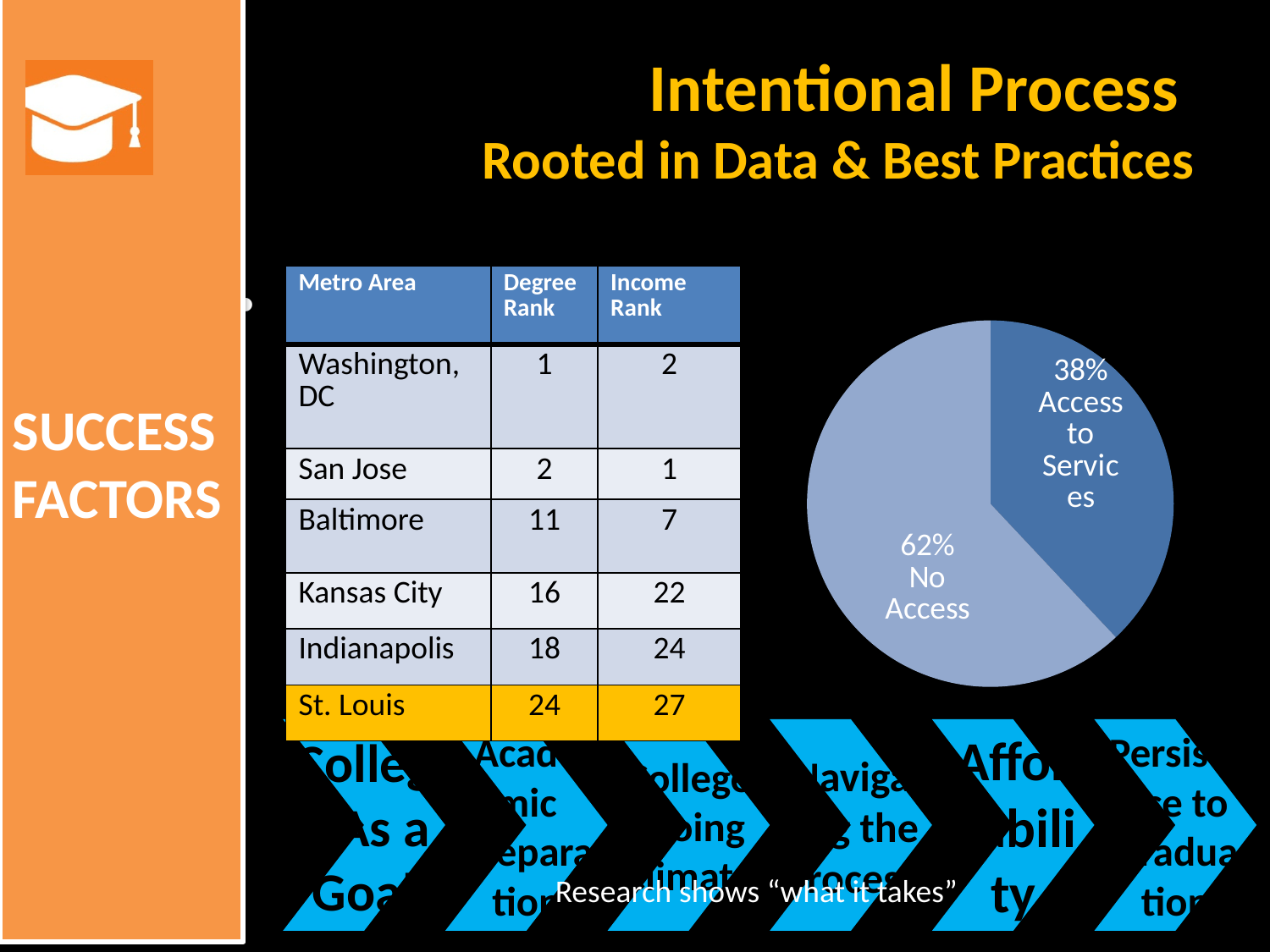
What kind of chart is shown on the slide? pie chart Is the "No Access" share in the pie chart greater or less than 50%? greater In the pie chart, which is larger: the "No Access" slice or the "Access to Services" slice? No Access What do the two slices of the pie chart add up to? 100% In the pie chart, what percentage is labelled "Access to Services"? 38% In the pie chart, what percentage is labelled "No Access"? 62% What share of the pie chart does the "Access to Services" slice represent? 38% Which slice of the pie chart is the smallest? Access to Services By how many percentage points does the "No Access" slice exceed the "Access to Services" slice in the pie chart? 24 percentage points Which slice of the pie chart is the largest? No Access Which slice of the pie chart is drawn in the darker blue? Access to Services How many slices does the pie chart have? 2